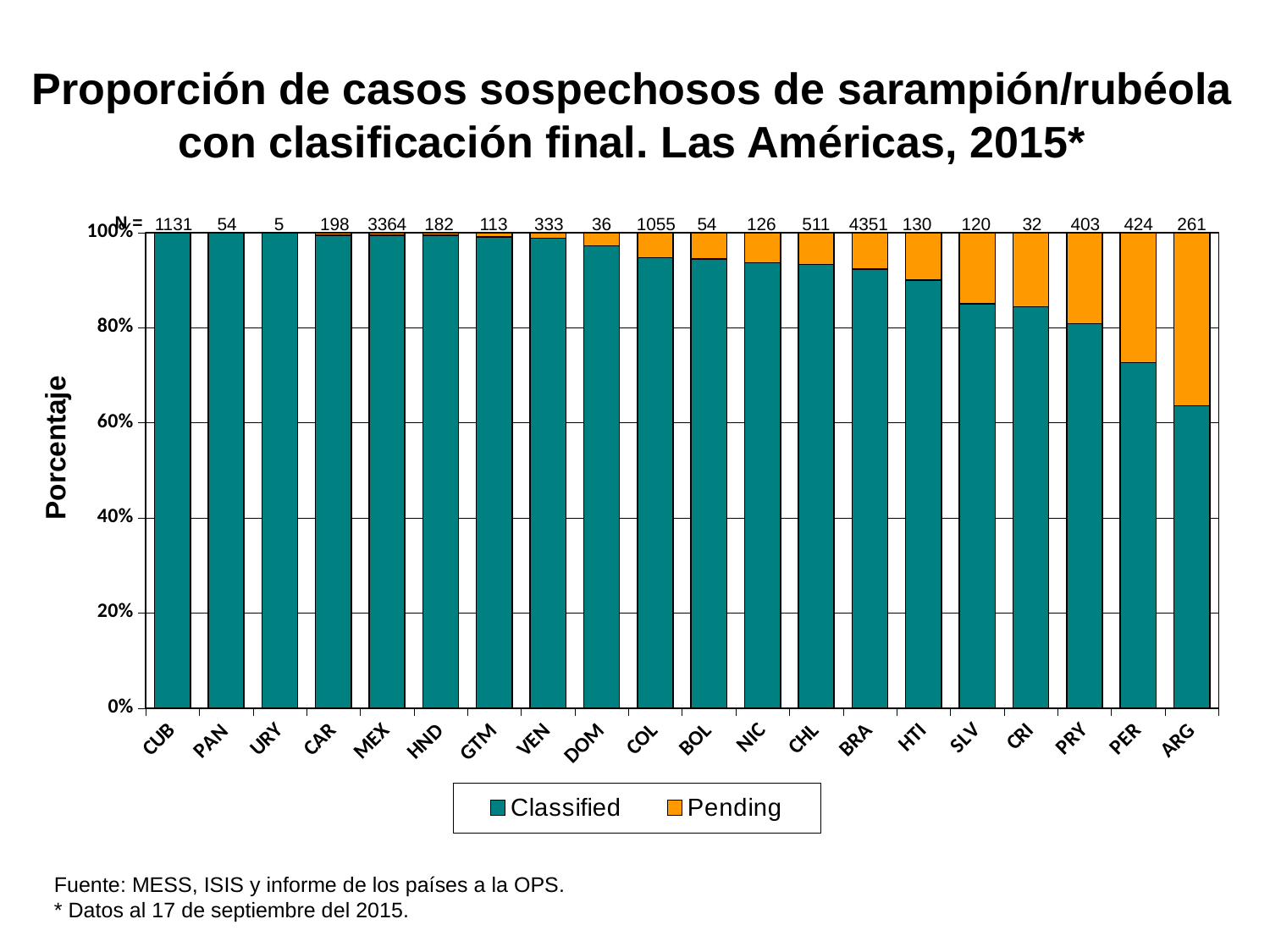
Which country has the largest N value printed above its bar? BRA How many series does the legend list? 2 What is the difference between the N values for BRA and MEX? 987 Is the Classified share for ARG greater or less than 80%? less What is the N value printed above the bar for PER? 424 What are the two series named in the legend? Classified and Pending Is the Classified share for SLV greater or less than 80%? greater What is the N value printed above the bar for MEX? 3364 What kind of chart is shown on the slide? Stacked bar chart Which country has the smallest N value printed above its bar? URY How many countries or regions are shown along the x axis? 20 Does the Classified share rise or fall moving from left to right along the x axis? Fall